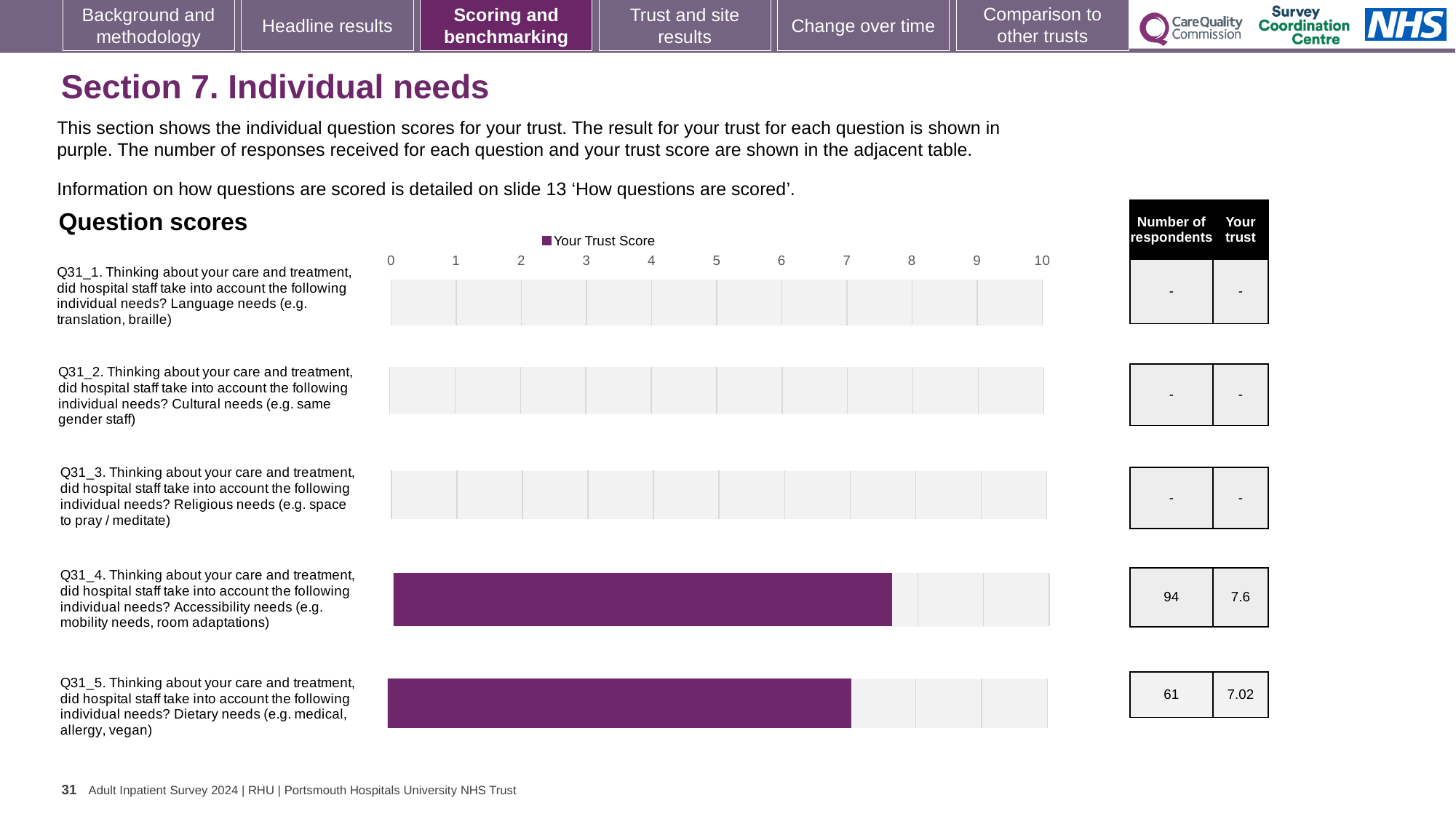
Is the trust score for Q31_4 (Accessibility needs) greater or less than 7? greater What is the maximum value shown on the score axis of the charts? 10 Is the trust score for Q31_5 (Dietary needs) greater or less than 8? less What is the difference between the trust scores for Q31_4 (Accessibility needs) and Q31_5 (Dietary needs)? 0.58 How many respondents answered Q31_5 (Dietary needs)? 61 What type of chart is used to show the question scores? Bar chart Which question has the higher trust score, Q31_4 (Accessibility needs) or Q31_5 (Dietary needs)? Q31_4 (Accessibility needs) How many questions are listed in the Question scores section of the slide? 5 How many questions on the slide have a trust score bar plotted? 2 What is the trust score for Q31_5 (Dietary needs)? 7.02 What is the trust score for Q31_4 (Accessibility needs)? 7.6 How many respondents answered Q31_4 (Accessibility needs)? 94